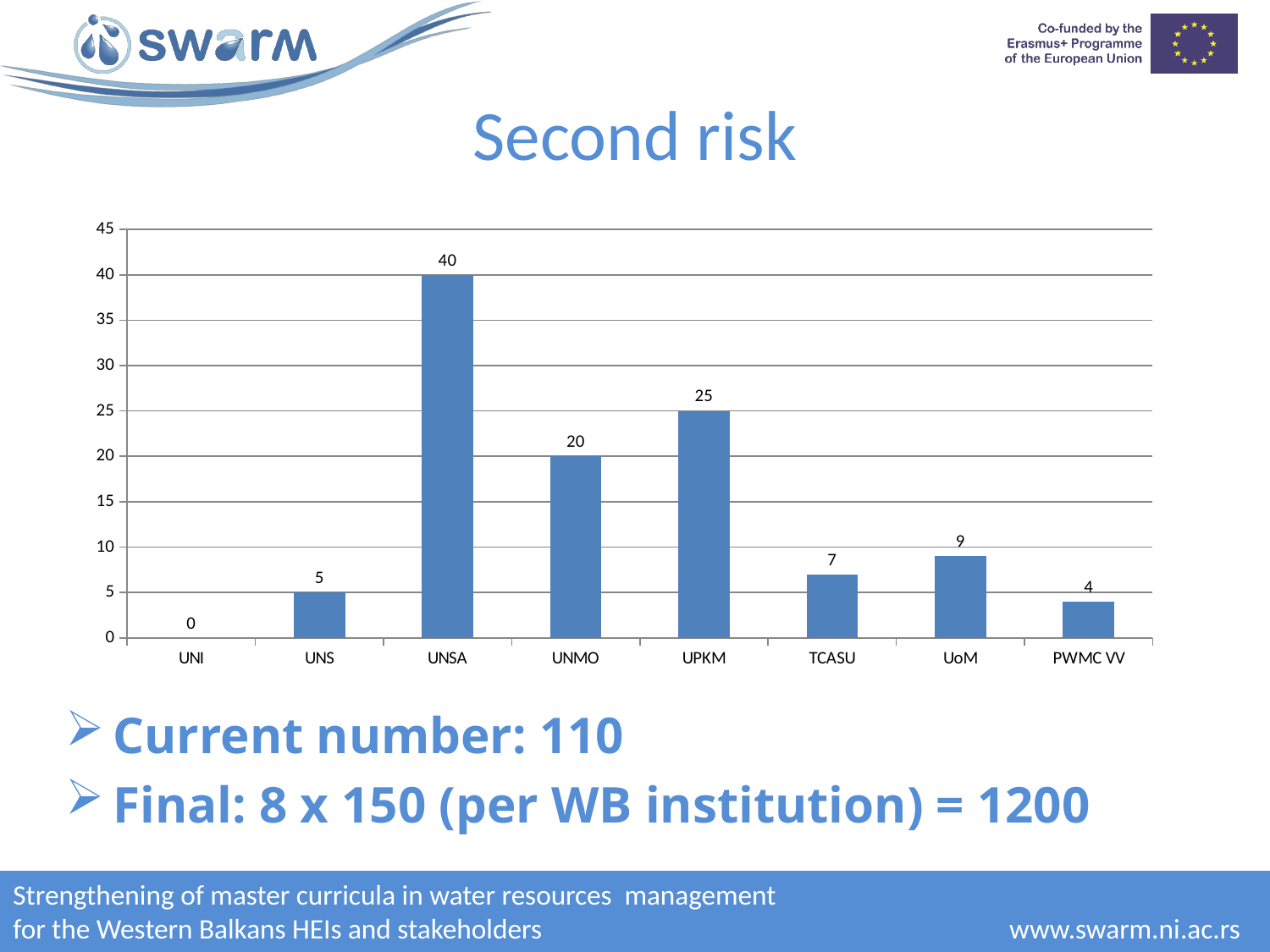
What is the title of the slide containing the chart? Second risk What is the difference between the values for UNSA and UNMO? 20 What is the value for PWMC VV? 4 What is the value for UPKM? 25 What is the value for TCASU? 7 Which category has the highest value? UNSA Which category has the lowest value? UNI What kind of chart is shown on the slide? bar chart How many categories are shown on the x axis? 8 What is the value for UNSA? 40 Is the value for UPKM greater or less than 20? greater Which is larger, the value for UoM or the value for UNS? UoM